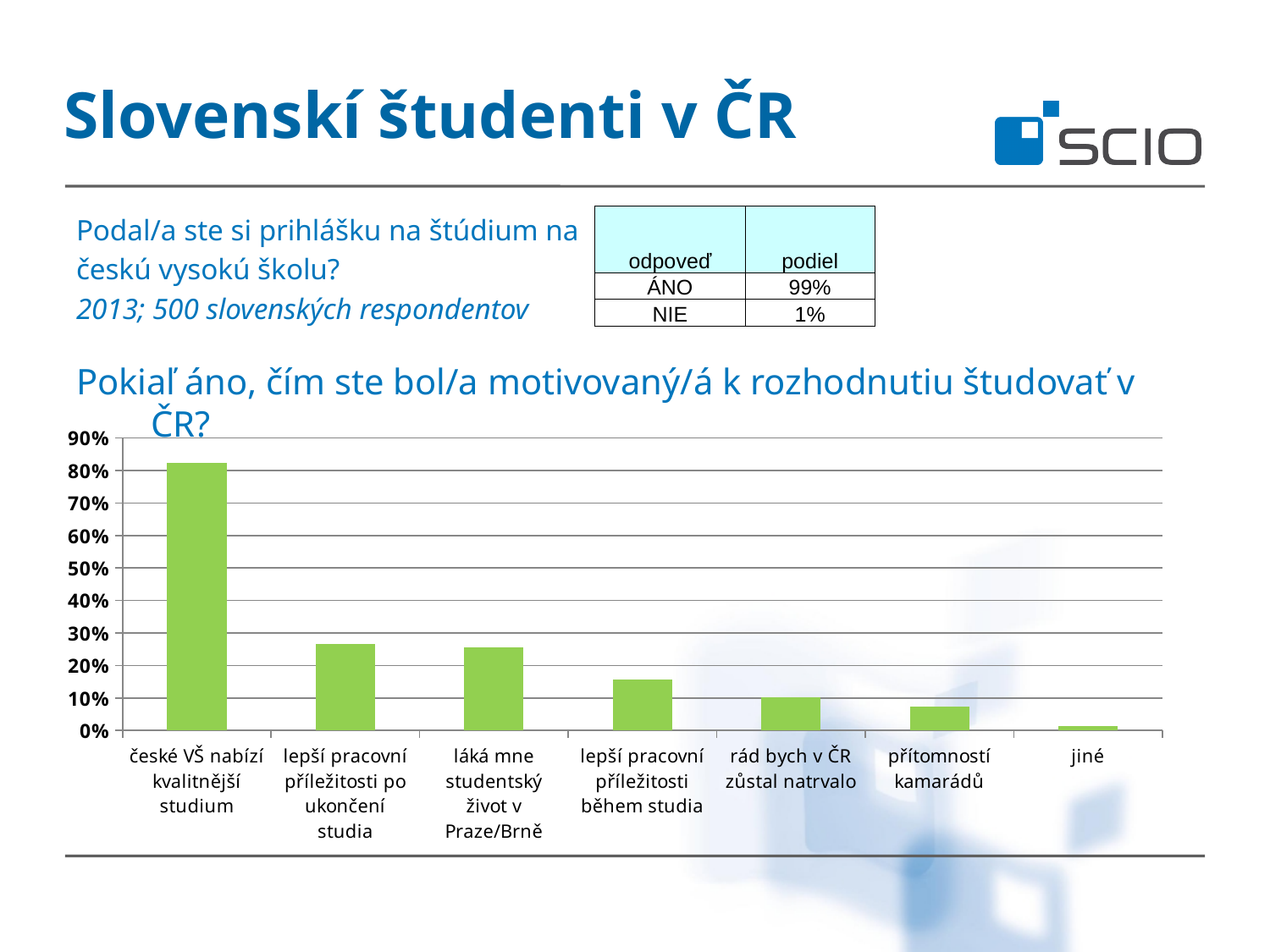
Is the value for 'přítomností kamarádů' greater or less than 10%? less Which is larger: the value for 'české VŠ nabízí kvalitnější studium' or the value for 'rád bych v ČR zůstal natrvalo'? české VŠ nabízí kvalitnější studium Do the bar values rise or fall from left to right along the x axis? fall Which category has the lowest value in the bar chart? jiné Which category has the highest value in the bar chart? české VŠ nabízí kvalitnější studium Is the value for 'české VŠ nabízí kvalitnější studium' greater or less than 70%? greater What kind of chart is shown on the slide? bar chart Is the value for 'láká mne studentský život v Praze/Brně' greater or less than 20%? greater How many categories are shown on the bar chart? 7 What colour are the bars in the chart? green